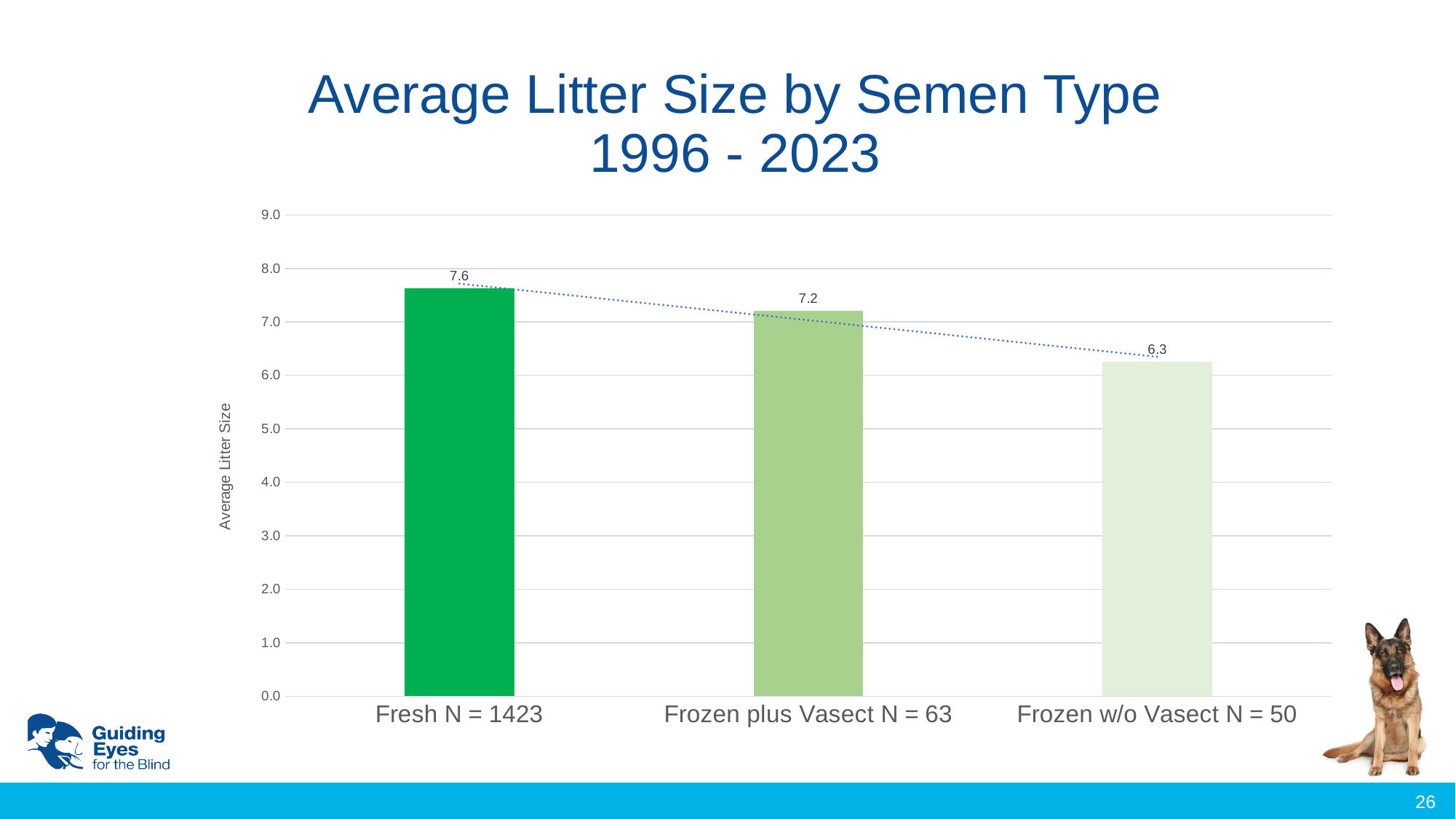
What is the average litter size for Frozen plus Vasect N = 63? 7.2 Which has a larger average litter size, Fresh N = 1423 or Frozen plus Vasect N = 63? Fresh N = 1423 Which semen type has the lowest average litter size? Frozen w/o Vasect N = 50 What kind of chart is shown on the slide? Bar chart What is the difference in average litter size between Frozen plus Vasect N = 63 and Frozen w/o Vasect N = 50? 0.9 What is the average litter size for Fresh N = 1423? 7.6 Do the average litter size values rise or fall from left to right across the categories? Fall What is the difference in average litter size between Fresh N = 1423 and Frozen w/o Vasect N = 50? 1.3 Is the average litter size for Frozen w/o Vasect N = 50 greater or less than 7.0? less Which semen type has the highest average litter size? Fresh N = 1423 What is the average litter size for Frozen w/o Vasect N = 50? 6.3 How many semen type categories are shown in the chart? 3